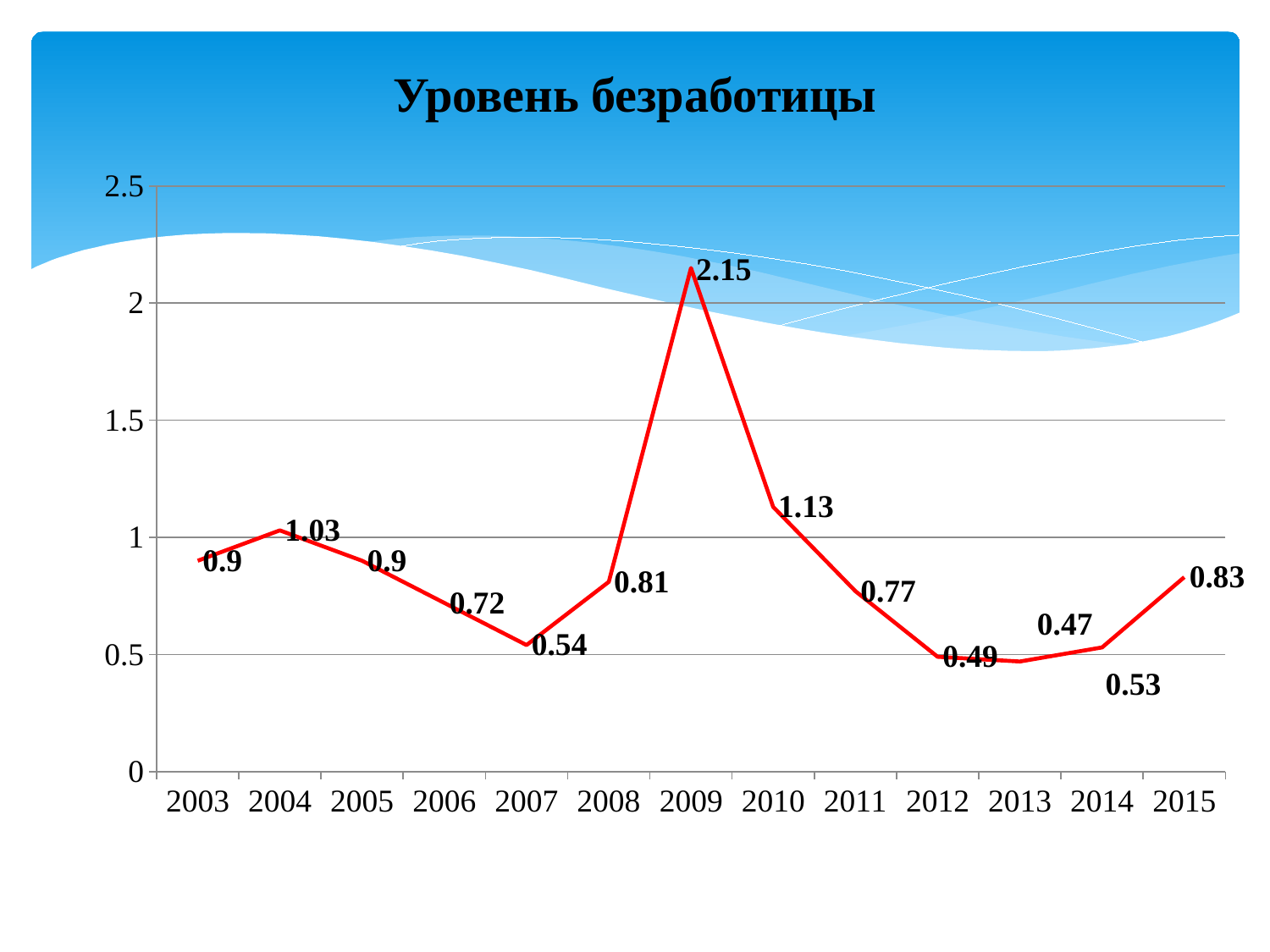
What type of chart is shown on the slide? line chart What is the value for 2015? 0.83 What is the title of the chart? Уровень безработицы Do the values rise or fall from 2009 to 2013? fall Which is larger, the value for 2004 or the value for 2008? 2004 How many years are plotted on the x axis? 13 What is the value for 2007? 0.54 Which year has the lowest value? 2013 Which year has the highest value? 2009 What is the difference between the values for 2009 and 2010? 1.02 Is the value for 2010 greater or less than 1? greater What is the value for 2009? 2.15